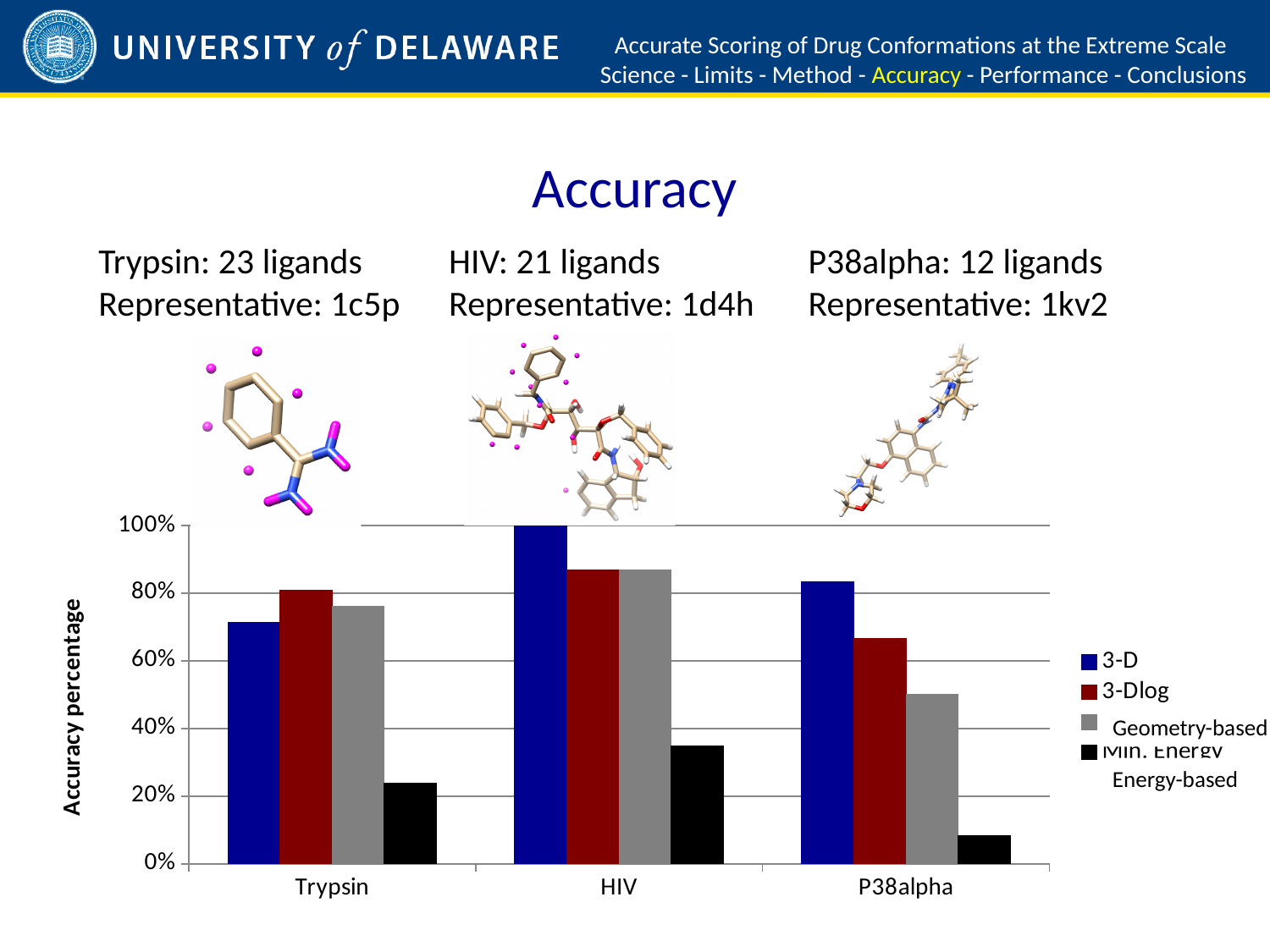
Is the 3-Dlog value for HIV greater or less than 80%? greater What kind of chart is shown on the slide? bar chart How many categories are shown on the x axis of the chart? 3 Which category has the highest 3-D bar? HIV Is the Energy-based value for HIV greater or less than 40%? less Is the Energy-based value for P38alpha greater or less than 20%? less What is the 3-D accuracy value for HIV? 100% What is the title of the vertical axis of the chart? Accuracy percentage Which category has the lowest Energy-based bar? P38alpha How many series does the chart's legend list? 4 For Trypsin, which is larger: the 3-D bar or the 3-Dlog bar? 3-Dlog